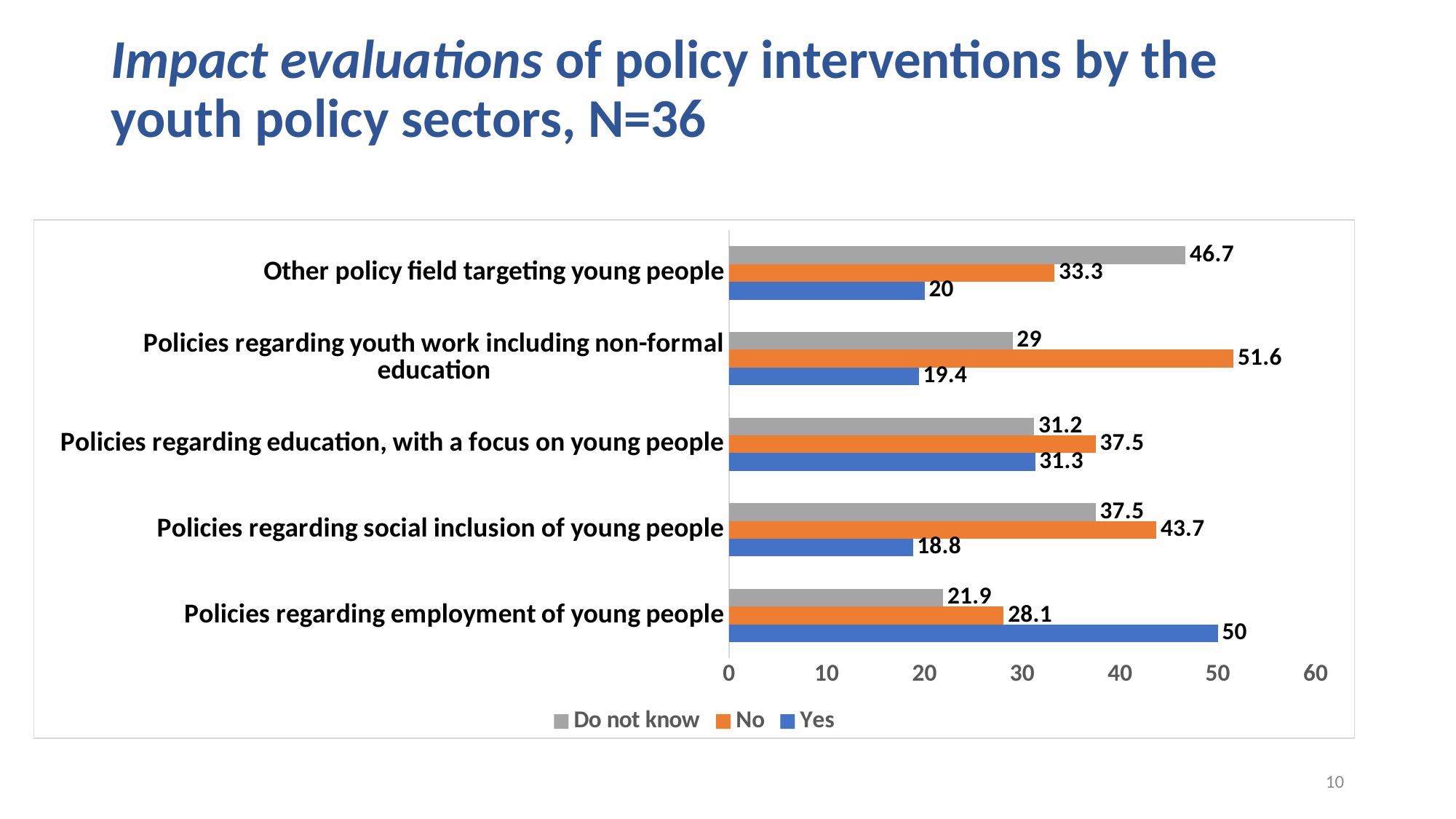
Which category has the lowest 'Do not know' value? Policies regarding employment of young people What is the 'Do not know' value for Other policy field targeting young people? 46.7 What is the difference between the 'No' and 'Yes' values for Policies regarding social inclusion of young people? 24.9 For Policies regarding education, with a focus on young people, which is larger: the 'No' value or the 'Do not know' value? No Which category has the lowest 'Yes' value? Policies regarding social inclusion of young people Which colour represents the 'No' series in the chart? Orange How many categories are shown on the chart? 5 How many series does the legend list? 3 Which category has the highest 'Yes' value? Policies regarding employment of young people What is the 'No' value for Policies regarding youth work including non-formal education? 51.6 What kind of chart is shown on the slide? Bar chart What is the 'Yes' value for Policies regarding employment of young people? 50